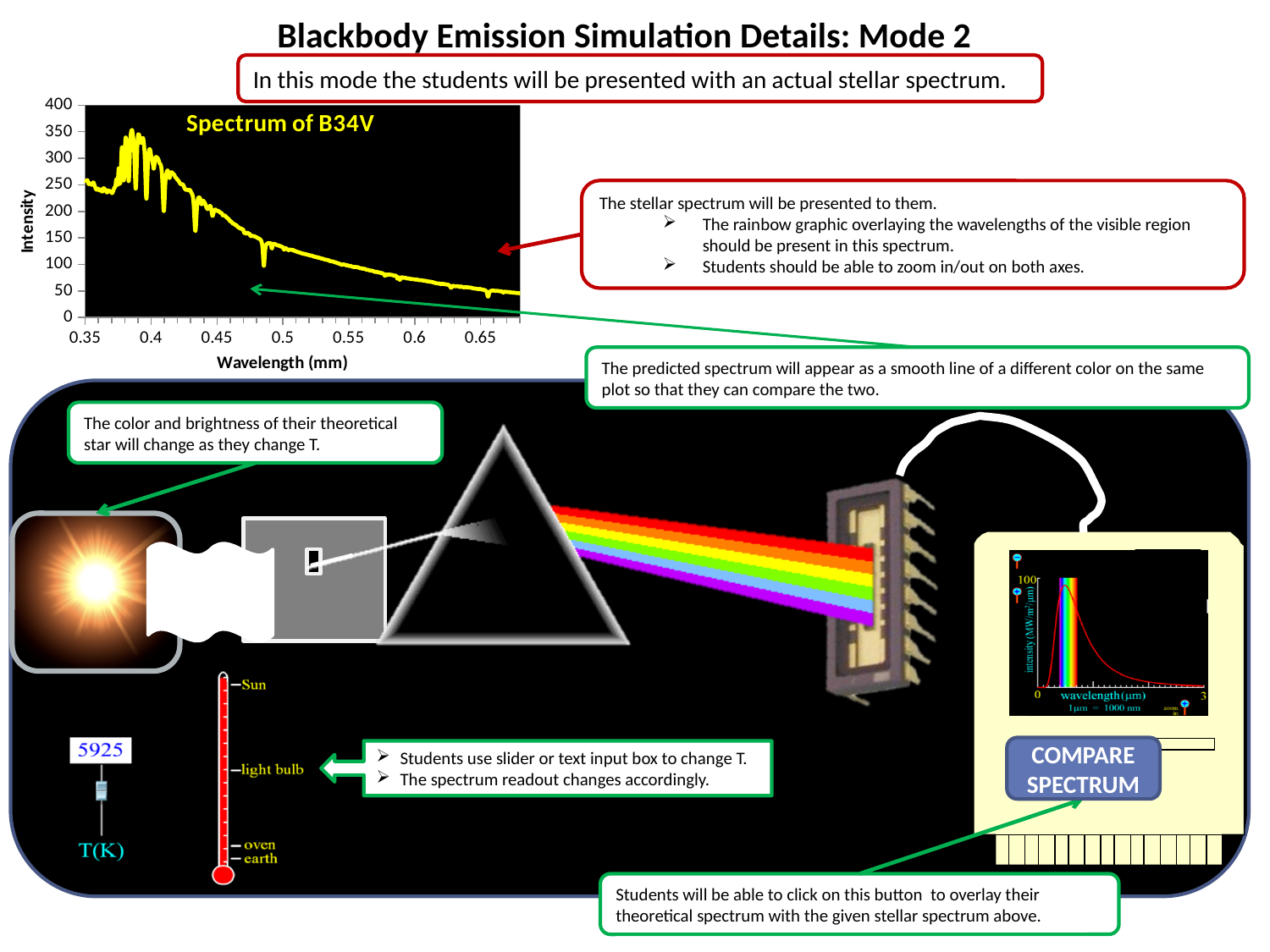
How many data series are plotted on the 'Spectrum of B34V' chart? 1 On the 'Spectrum of B34V' chart, is the intensity at a wavelength of 0.5 greater or less than 150? less What is the title of the chart in the upper left of the slide? Spectrum of B34V On the 'Spectrum of B34V' chart, is the intensity at a wavelength of 0.6 greater or less than 100? less On the 'Spectrum of B34V' chart, is the peak intensity of the spectrum greater or less than 300? greater On the 'Spectrum of B34V' chart, does the intensity generally rise or fall as wavelength increases from 0.4 to 0.65? fall What is the label of the x axis on the 'Spectrum of B34V' chart? Wavelength (mm) What kind of chart is the 'Spectrum of B34V' chart? line chart On the 'Spectrum of B34V' chart, which has the higher intensity: the wavelength 0.4 or the wavelength 0.6? 0.4